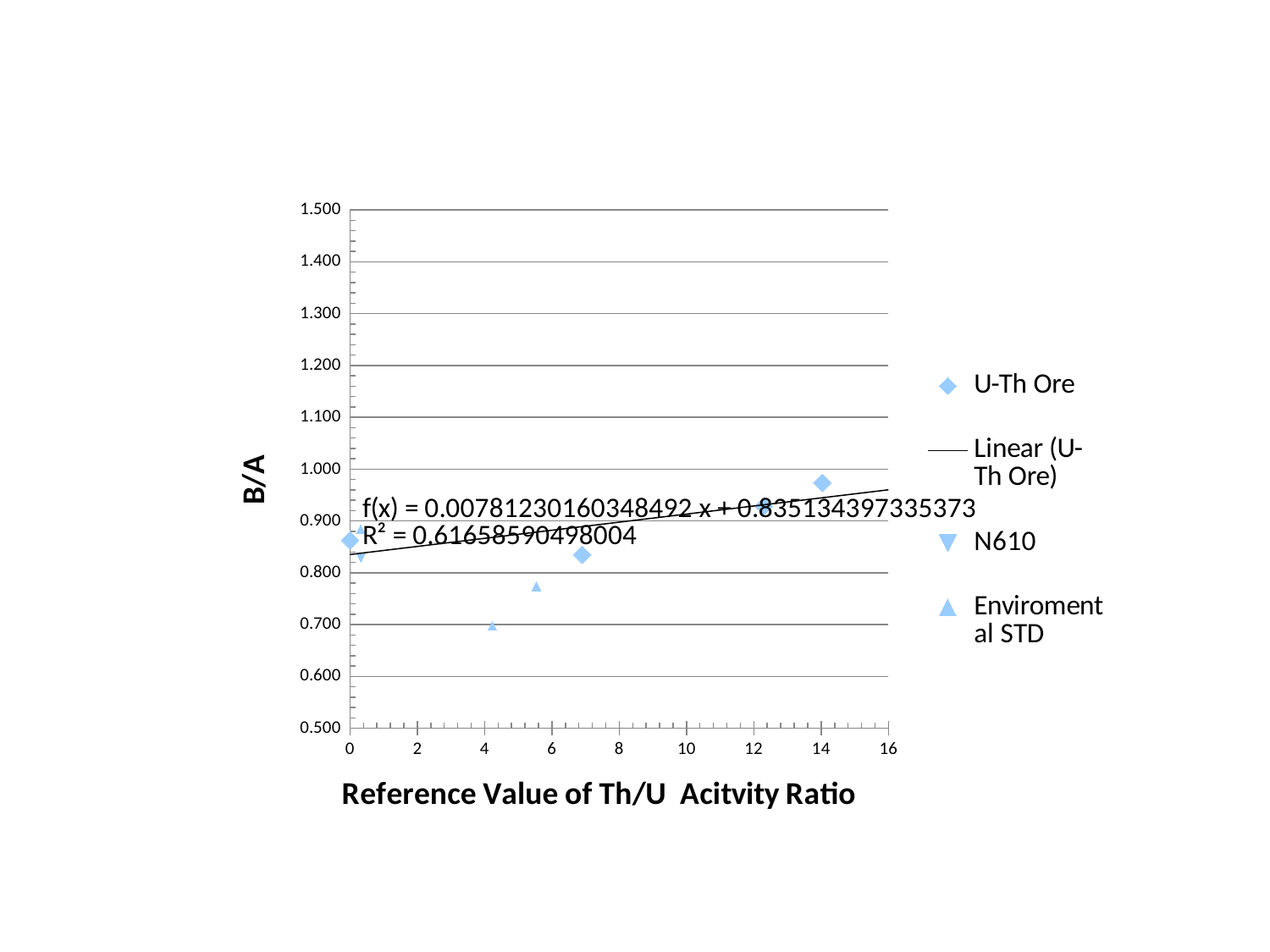
What is the slope of the linear trendline equation printed on the chart? 0.00781230160348492 How many entries does the chart legend list? 4 Is the B/A value of the U-Th Ore point at x = 14 greater or less than 0.900? greater What is the title of the y axis? B/A Is the B/A value of the Enviromental STD point near x = 5.5 greater or less than 0.800? less What is the R² value printed on the chart? 0.61658590498004 Does the Linear (U-Th Ore) trendline rise or fall as the x value increases? rise What kind of chart is shown on the slide? scatter chart What is the intercept of the linear trendline equation printed on the chart? 0.835134397335373 Is the B/A value of the U-Th Ore point near x = 7 greater or less than 0.900? less What is the title of the x axis? Reference Value of Th/U Acitvity Ratio